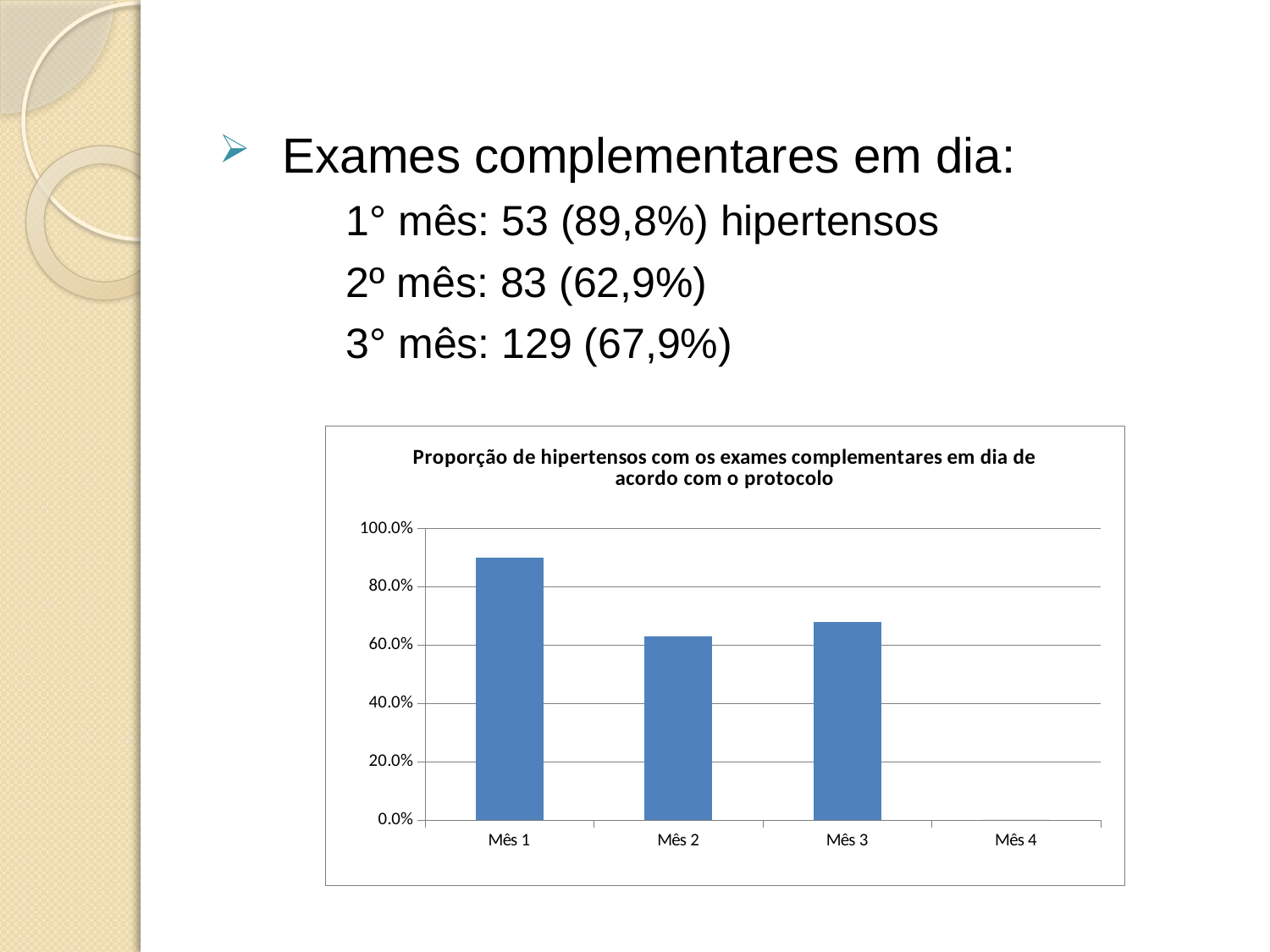
According to the slide text, what proportion of hypertensive patients had their complementary exams up to date in the 3rd month? 67,9% Is the value for Mês 2 greater or less than 80.0%? less What is the title of the chart? Proporção de hipertensos com os exames complementares em dia de acordo com o protocolo According to the slide text, what proportion of hypertensive patients had their complementary exams up to date in the 1st month? 89,8% Which month on the x axis has no bar plotted in the chart? Mês 4 Which is larger in the chart, the bar for Mês 2 or the bar for Mês 3? Mês 3 How many categories are shown on the x axis of the chart? 4 What type of chart is shown on the slide? bar chart Is the value for Mês 1 greater or less than 80.0%? greater According to the slide text, what proportion of hypertensive patients had their complementary exams up to date in the 2nd month? 62,9% Which month has the highest bar in the chart? Mês 1 Is the value for Mês 3 greater or less than 60.0%? greater